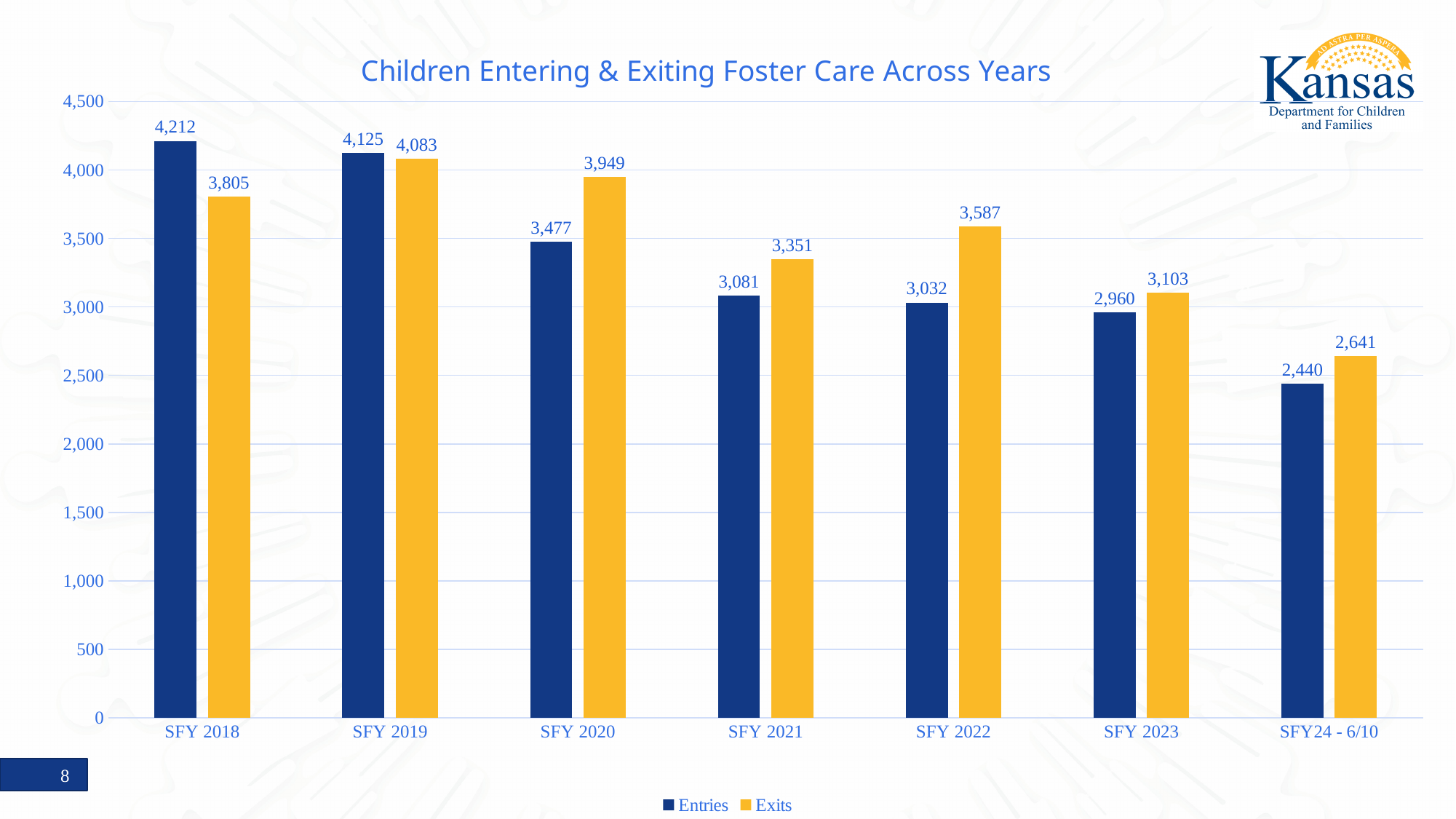
Which year has the lowest number of Exits? SFY24 - 6/10 What is the number of Entries for SFY24 - 6/10? 2,440 What is the number of Exits for SFY 2020? 3,949 Do the Entries values rise or fall from SFY 2018 to SFY24 - 6/10? Fall What is the number of Entries for SFY 2018? 4,212 Which is larger in SFY 2022, Entries or Exits? Exits How many series does the legend list? 2 Is the value for Exits in SFY 2023 greater or less than 3,000? greater What kind of chart is shown on the slide? Bar chart Which year has the highest number of Entries? SFY 2018 How many years are shown on the x axis? 7 What is the difference between Entries and Exits in SFY 2018? 407